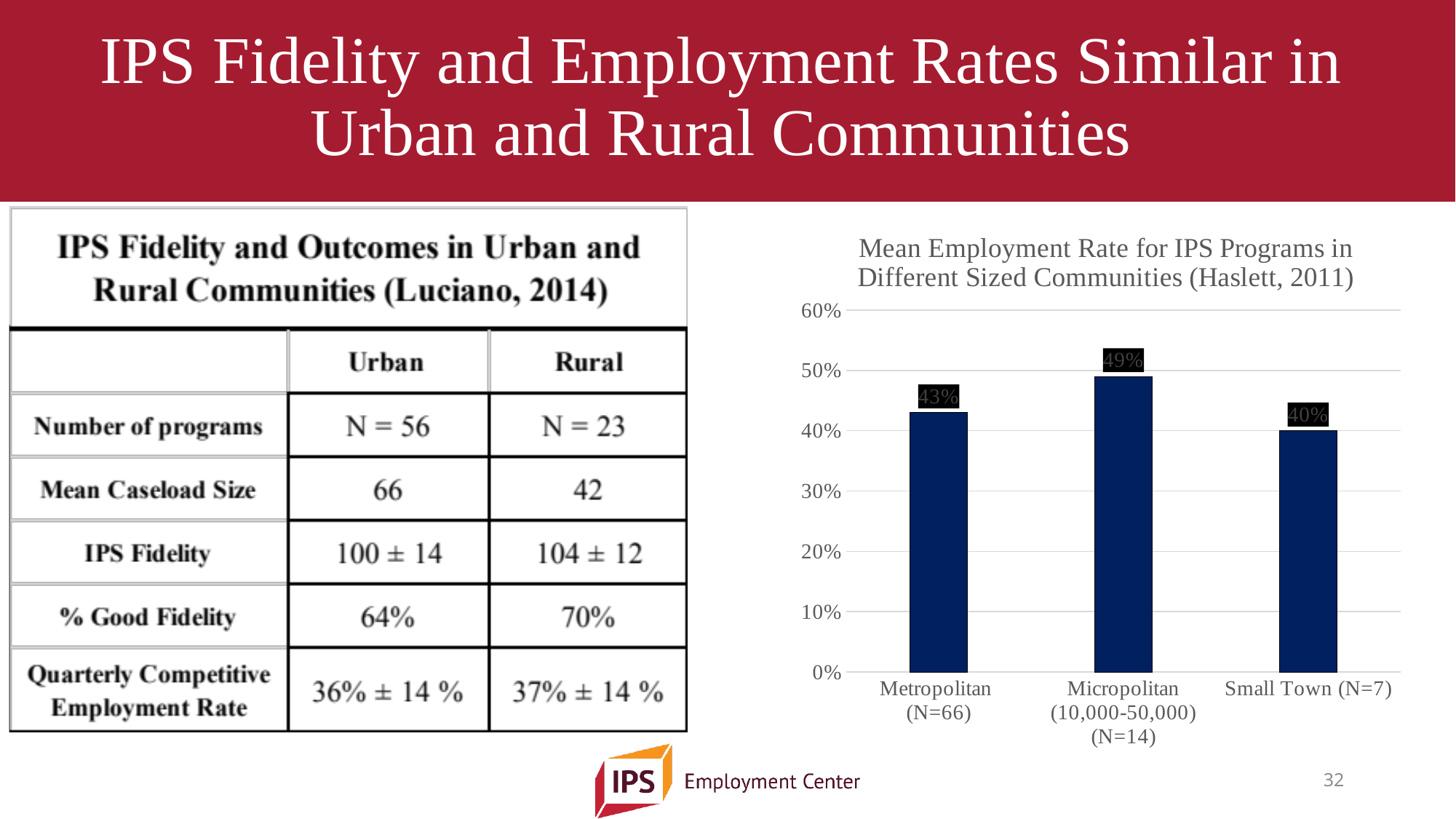
Which community size has the highest mean employment rate in the chart? Micropolitan (10,000-50,000) (N=14) What is the mean employment rate for Micropolitan (10,000-50,000) (N=14) programs in the chart? 49% Is the mean employment rate for Micropolitan programs greater or less than 40%? greater What kind of chart is used to show the mean employment rate for IPS programs? Bar chart Which community size has the lowest mean employment rate in the chart? Small Town (N=7) Which has a higher mean employment rate, Metropolitan or Micropolitan programs? Micropolitan What is the difference between the mean employment rates for Metropolitan and Small Town programs? 3% What is the mean employment rate for Small Town (N=7) programs in the chart? 40% How many community size categories are shown in the chart? 3 What is the difference between the mean employment rates for Micropolitan and Small Town programs? 9% What is the mean employment rate for Metropolitan (N=66) programs in the chart? 43% What is the title of the chart on the slide? Mean Employment Rate for IPS Programs in Different Sized Communities (Haslett, 2011)